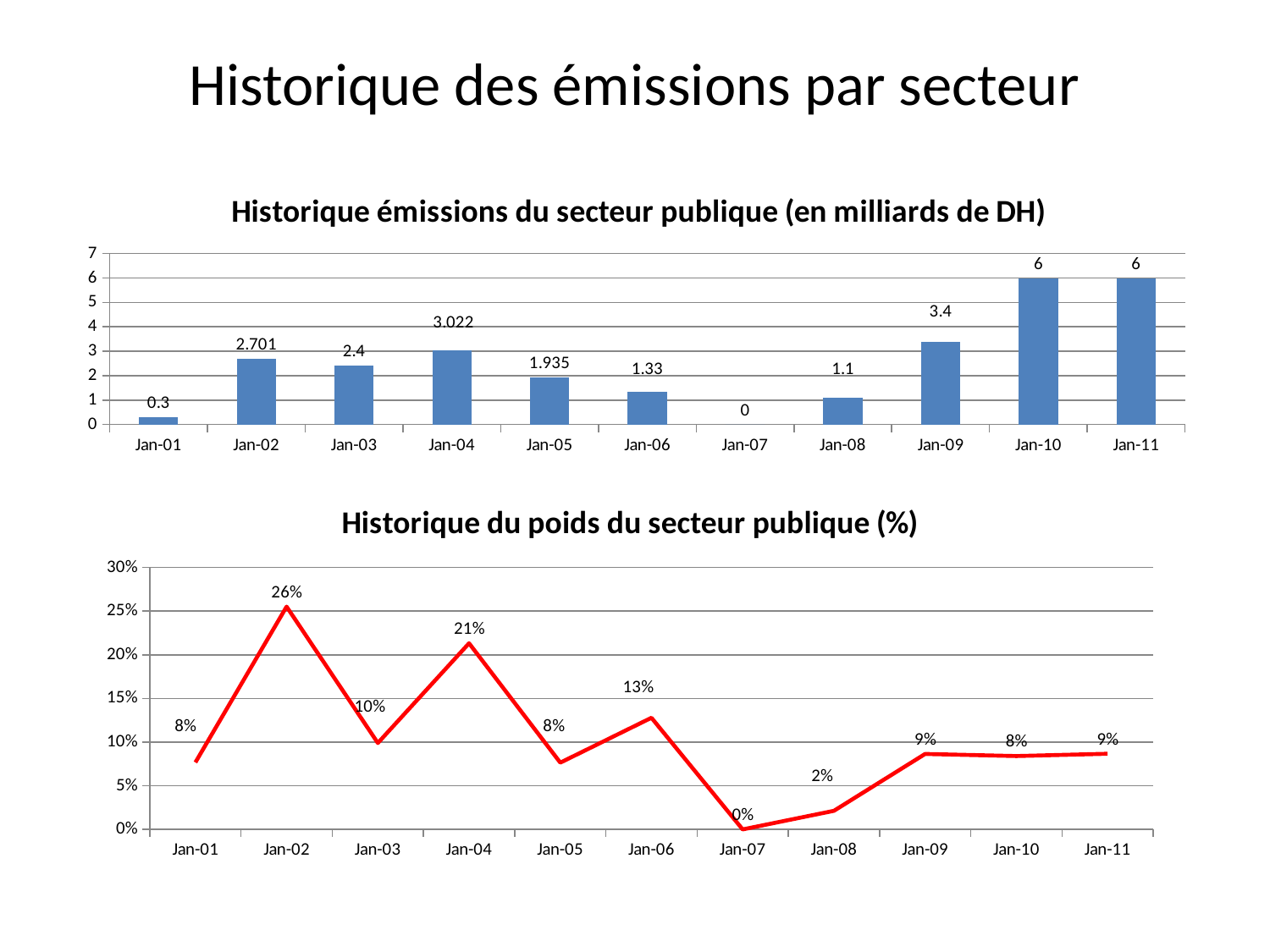
In the chart 'Historique émissions du secteur publique (en milliards de DH)', what is the difference between the values for Jan-02 and Jan-03? 0.301 In the chart 'Historique émissions du secteur publique (en milliards de DH)', what is the value for Jan-04? 3.022 In the chart 'Historique du poids du secteur publique (%)', what is the value for Jan-02? 26% What kind of chart is 'Historique émissions du secteur publique (en milliards de DH)'? Bar chart What kind of chart is 'Historique du poids du secteur publique (%)'? Line chart In the chart 'Historique émissions du secteur publique (en milliards de DH)', which is larger, the value for Jan-05 or the value for Jan-06? Jan-05 In the chart 'Historique du poids du secteur publique (%)', what is the difference between the values for Jan-04 and Jan-05? 13% In the chart 'Historique émissions du secteur publique (en milliards de DH)', what is the value for Jan-09? 3.4 In the chart 'Historique émissions du secteur publique (en milliards de DH)', how many categories are shown on the x axis? 11 In the chart 'Historique du poids du secteur publique (%)', which category has the highest value? Jan-02 In the chart 'Historique émissions du secteur publique (en milliards de DH)', which category has the lowest value? Jan-07 In the chart 'Historique du poids du secteur publique (%)', what is the value for Jan-06? 13%